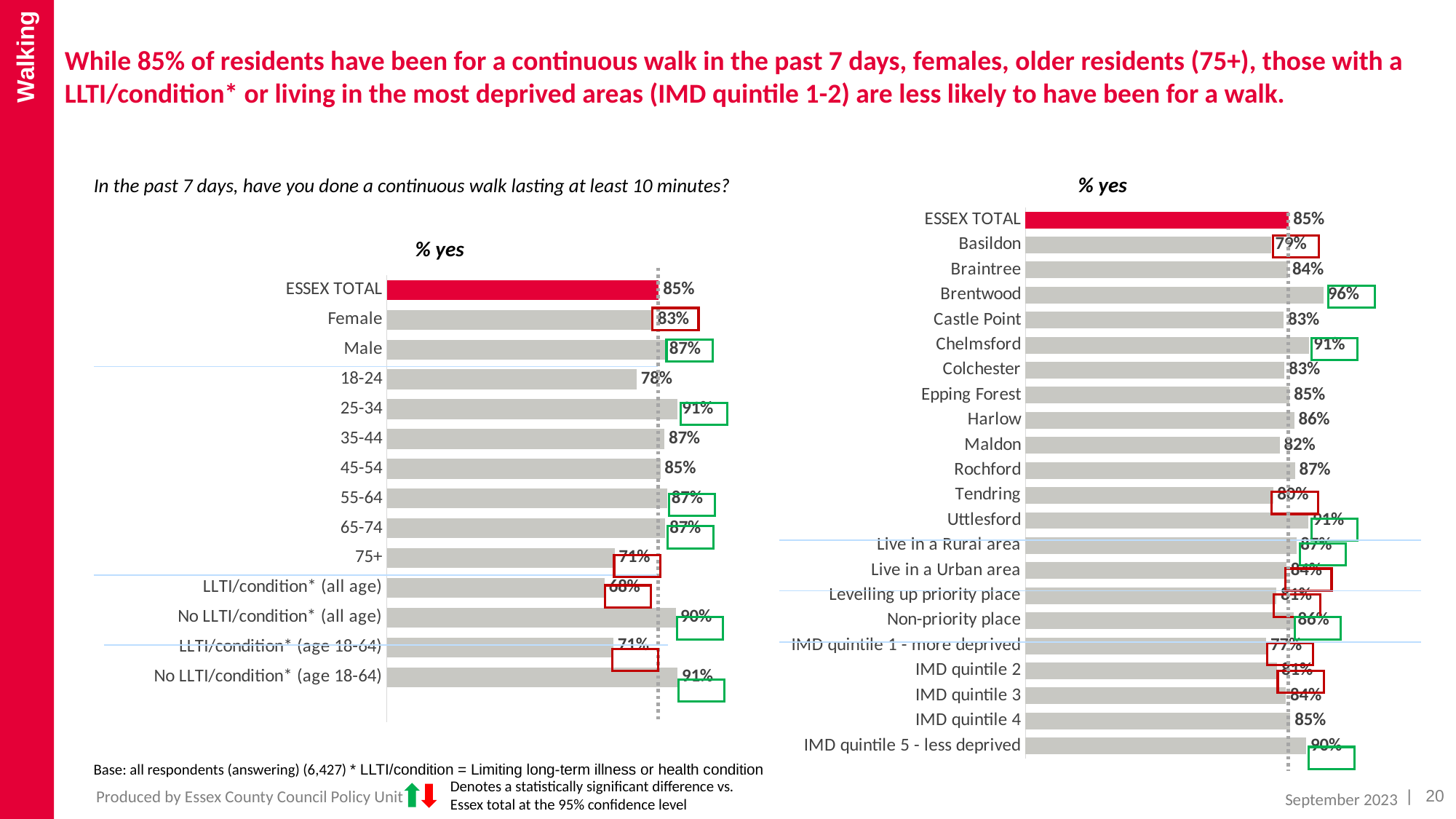
On the left chart, which is larger, the value for 18-24 or the value for 25-34? 25-34 On the left chart, what is the % yes value for the 75+ age group? 71% On the right chart, what is the % yes value for Basildon? 79% What colour is the ESSEX TOTAL bar on both charts? Red On the right chart, what is the difference between the values for Brentwood and Maldon? 14% On the left chart, which category has the lowest % yes value? LLTI/condition* (all age) On the left chart, what is the difference between the values for Male and Female? 4% On the left chart, what is the % yes value for Female? 83% What type of chart is shown on the left of the slide? Bar chart On the right chart, what is the % yes value for IMD quintile 1 - more deprived? 77% On the right chart, which is larger, the value for Chelmsford or the value for Harlow? Chelmsford On the right chart, which district has the highest % yes value? Brentwood